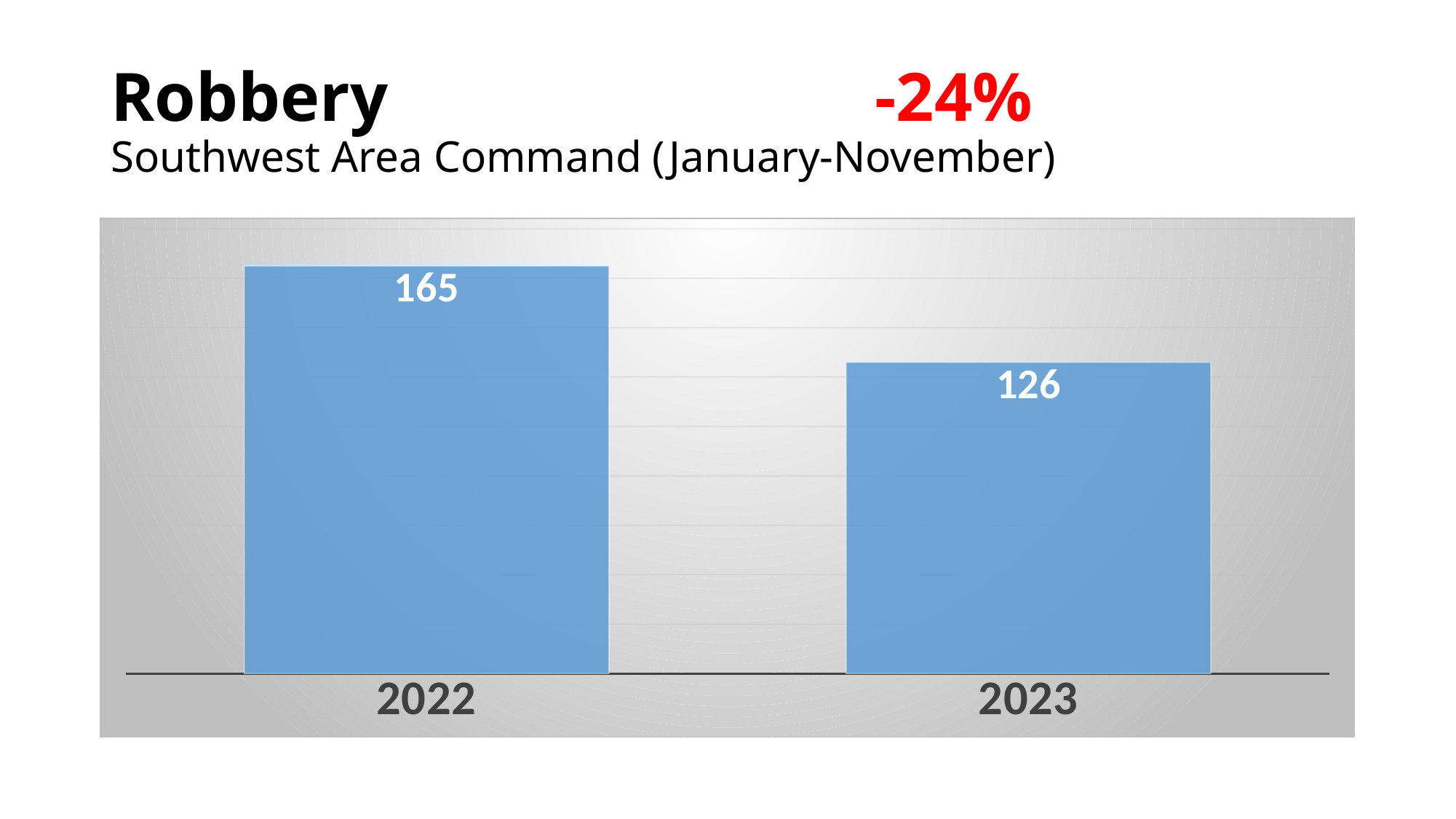
What kind of chart is shown on the slide? bar chart How many categories are shown on the x axis? 2 What is the robbery value for 2023? 126 What is the subtitle shown under the chart title 'Robbery'? Southwest Area Command (January-November) What percentage change is shown in red at the top of the slide? -24% Do the values rise or fall from 2022 to 2023? fall Which year has the higher robbery value? 2022 Which year has the lower robbery value? 2023 Is the value for 2022 larger or smaller than the value for 2023? larger What is the difference between the 2022 and 2023 robbery values? 39 What is the robbery value for 2022? 165 What is the total of the two robbery values shown? 291